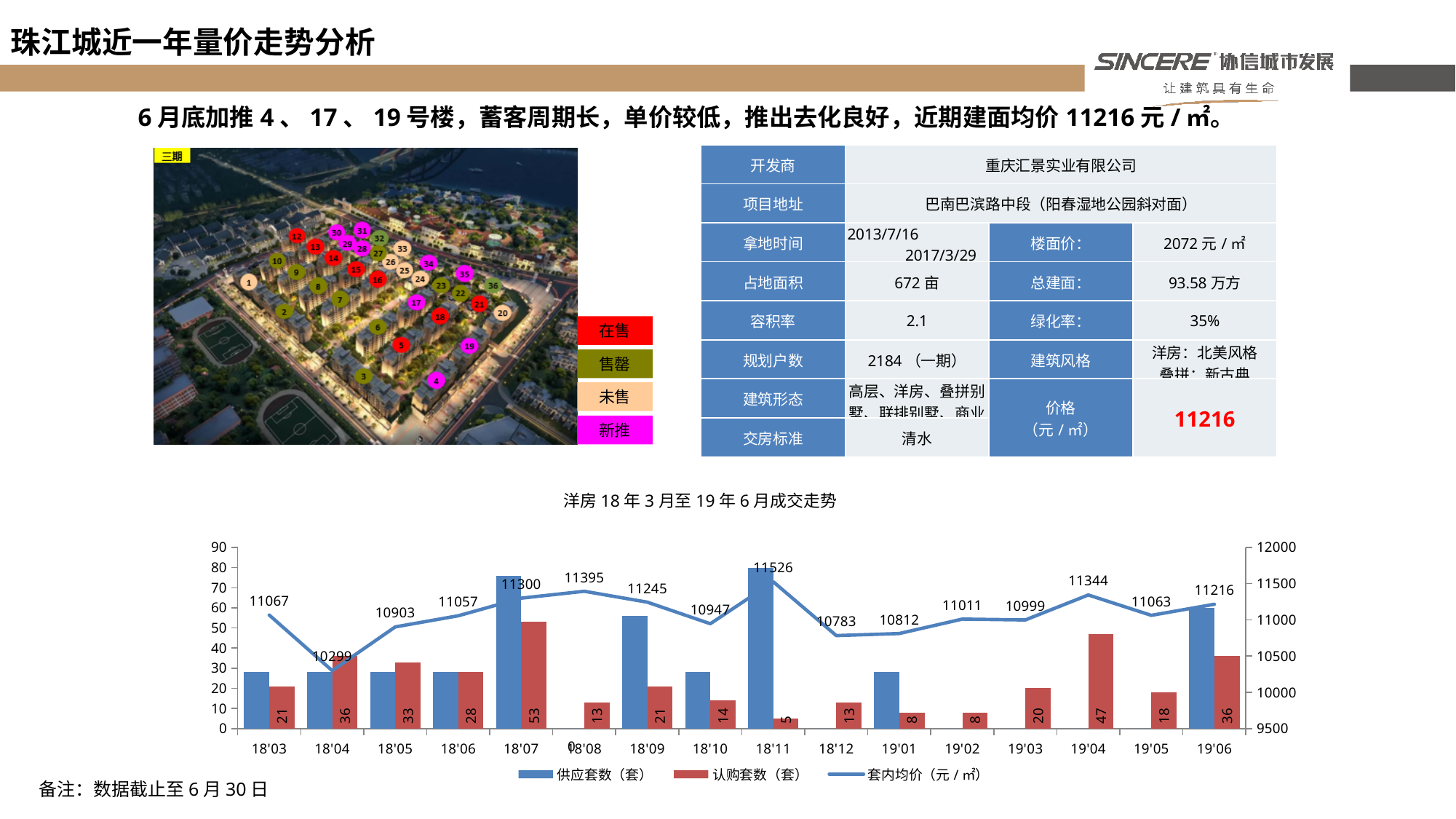
Which month has the lowest 套内均价? 18'04 How many months are shown on the x axis of the chart? 16 Which month has the highest 套内均价? 18'11 How many series does the chart legend list? 3 Which is larger, the 认购套数 for 18'05 or for 19'03? 18'05 What is the difference between the 套内均价 values for 18'11 and 18'04? 1227 Which month has the lowest 认购套数? 18'11 What is the 认购套数 value for 18'07? 53 Is the 供应套数 value for 18'03 greater or less than 40? less Is the 供应套数 value for 18'11 greater or less than 70? greater What is the difference between the 认购套数 values for 19'04 and 19'05? 29 What is the 套内均价 value for 18'11? 11526